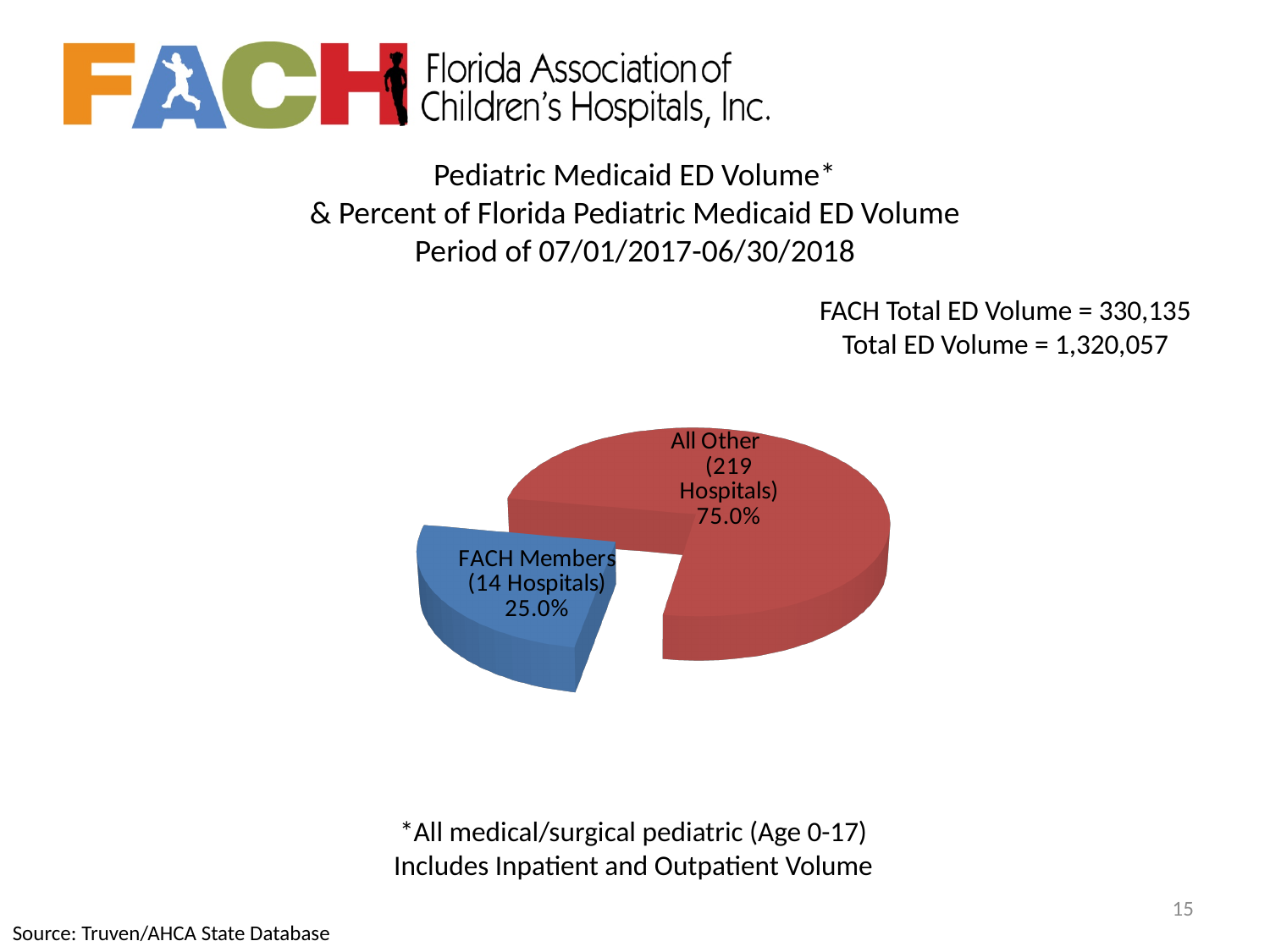
What percentage of Florida pediatric Medicaid ED volume is attributed to All Other hospitals? 75.0% How many hospitals are included in the All Other slice? 219 Hospitals What is the difference in percentage points between the All Other slice and the FACH Members slice? 50.0 percentage points How many hospitals are included in the FACH Members slice? 14 Hospitals What percentage of Florida pediatric Medicaid ED volume is attributed to FACH Members? 25.0% What is the FACH Total ED Volume stated on the slide? 330,135 What colour is the FACH Members slice of the pie chart? Blue What type of chart is shown on the slide? Pie chart Which slice of the pie chart is the largest? All Other (219 Hospitals) Which is larger, the share for FACH Members or the share for All Other? All Other How many slices does the pie chart have? 2 Which slice of the pie chart is the smallest? FACH Members (14 Hospitals)